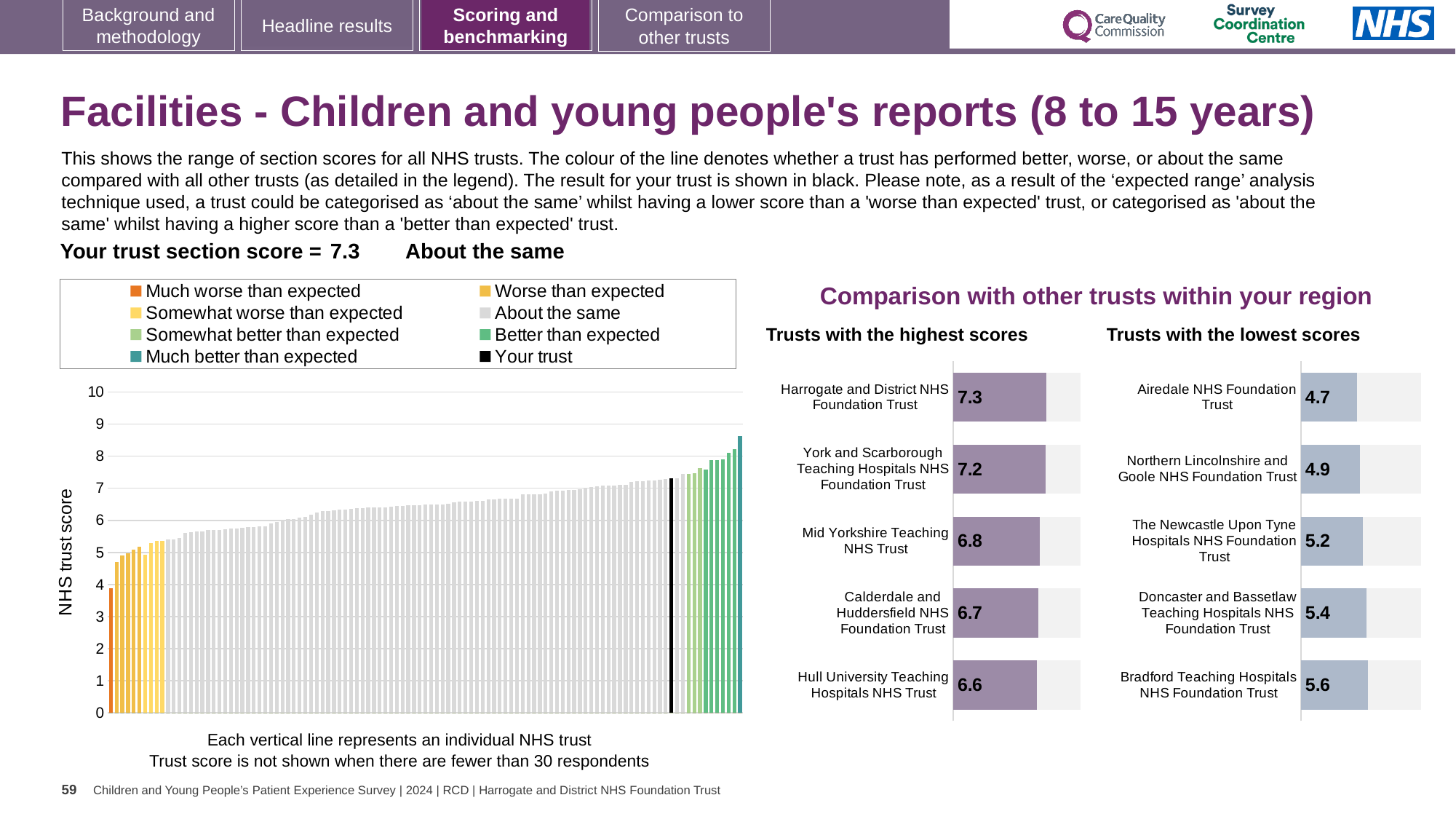
In the 'Trusts with the highest scores' chart, which has the larger score: York and Scarborough Teaching Hospitals NHS Foundation Trust or Calderdale and Huddersfield NHS Foundation Trust? York and Scarborough Teaching Hospitals NHS Foundation Trust In the 'Trusts with the highest scores' chart, what is the score for Harrogate and District NHS Foundation Trust? 7.3 In the 'Trusts with the highest scores' chart, what is the score for Mid Yorkshire Teaching NHS Trust? 6.8 In the 'Trusts with the lowest scores' chart, what is the score for Airedale NHS Foundation Trust? 4.7 In the 'Trusts with the lowest scores' chart, what is the score for Doncaster and Bassetlaw Teaching Hospitals NHS Foundation Trust? 5.4 What kind of chart is the large chart on the left showing NHS trust scores? Bar chart In the 'Trusts with the highest scores' chart, which trust has the lowest score shown? Hull University Teaching Hospitals NHS Trust How many trusts are listed in the 'Trusts with the lowest scores' chart? 5 In the 'Trusts with the lowest scores' chart, which trust has the highest score shown? Bradford Teaching Hospitals NHS Foundation Trust In the large chart on the left, do the trust scores rise or fall from left to right? Rise What is the difference between the score for Harrogate and District NHS Foundation Trust (7.3) and Airedale NHS Foundation Trust (4.7)? 2.6 How many entries does the legend above the large chart on the left list? 8